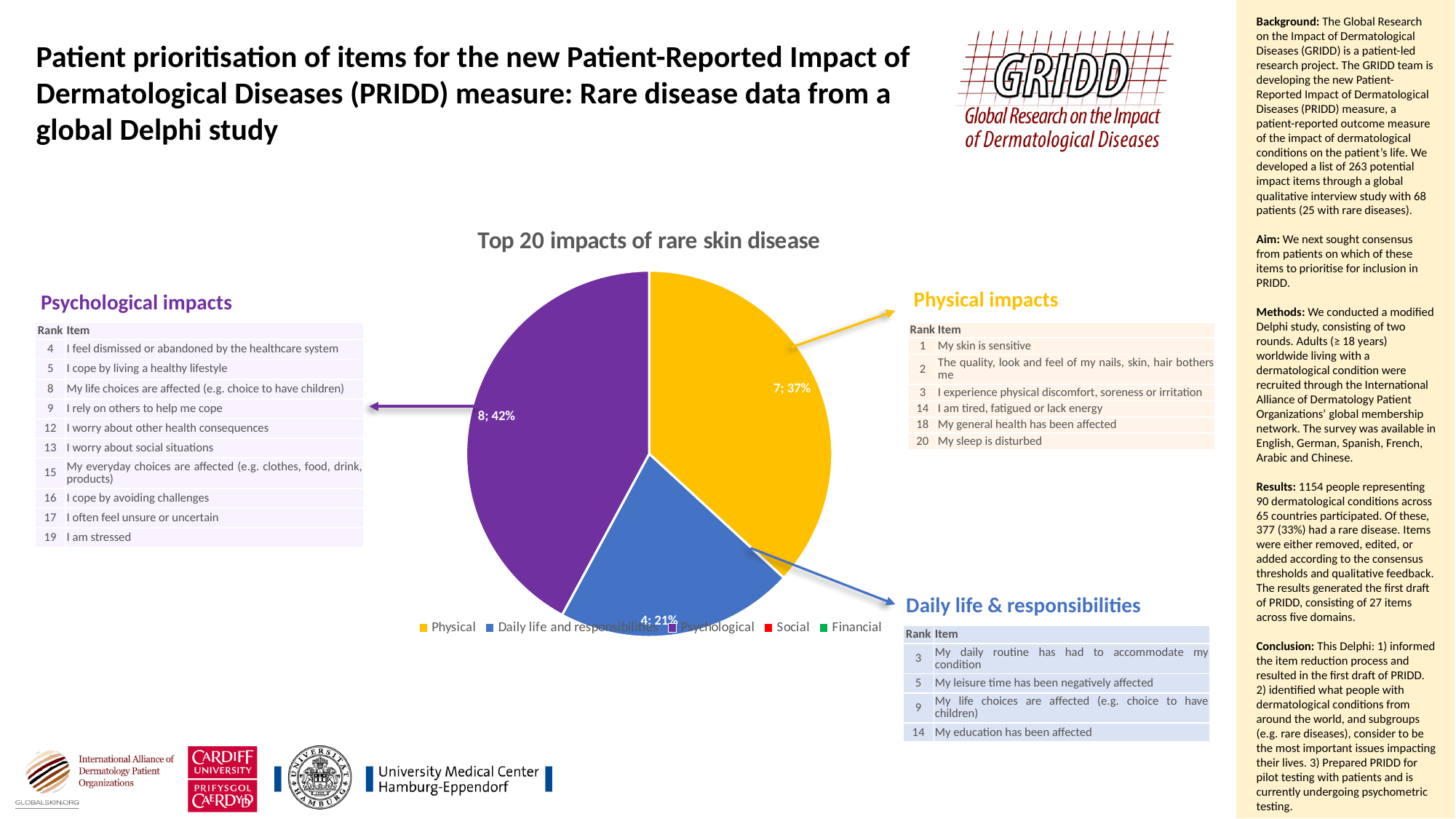
How many items does the data label show for the Physical slice? 7 What percentage of the pie does the Daily life and responsibilities slice represent? 21% Which category has the largest slice of the pie? Psychological What colour is the Physical slice of the pie chart? yellow How many categories are listed in the pie chart's legend? 5 What is the difference in item count between the Psychological slice (8) and the Physical slice (7)? 1 What is the title of the pie chart? Top 20 impacts of rare skin disease Which is larger, the Physical slice or the Daily life and responsibilities slice? Physical What percentage of the pie does the Psychological slice represent? 42% What kind of chart is shown on the slide? pie chart What percentage of the pie does the Physical slice represent? 37% How many items does the data label show for the Daily life and responsibilities slice? 4